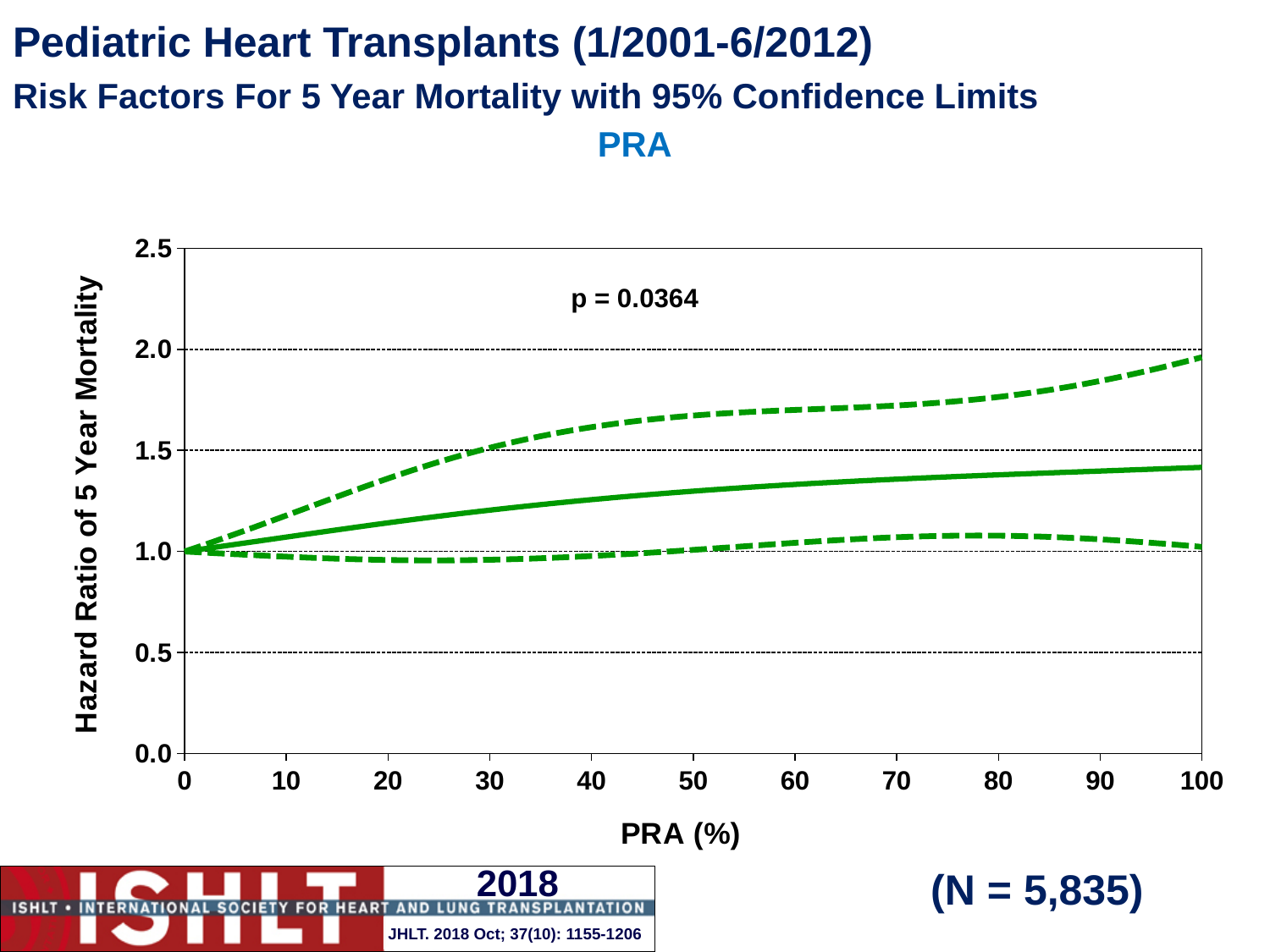
What kind of chart is shown on the slide? line chart Is the upper 95% confidence limit (upper dashed line) at a PRA of 100% greater or less than 1.5? greater What is the maximum value shown on the y axis of the chart? 2.5 Does the solid hazard ratio line rise or fall as PRA (%) increases from 0 to 100? rise What is the hazard ratio of 5 year mortality at a PRA of 0%? 1.0 How many lines are plotted on the chart? 3 Is the lower 95% confidence limit (lower dashed line) at a PRA of 100% greater or less than 1.5? less What is the sample size (N) shown on the slide? N = 5,835 What p-value is printed on the chart? p = 0.0364 Is the hazard ratio (solid line) at a PRA of 100% greater or less than 1.5? less